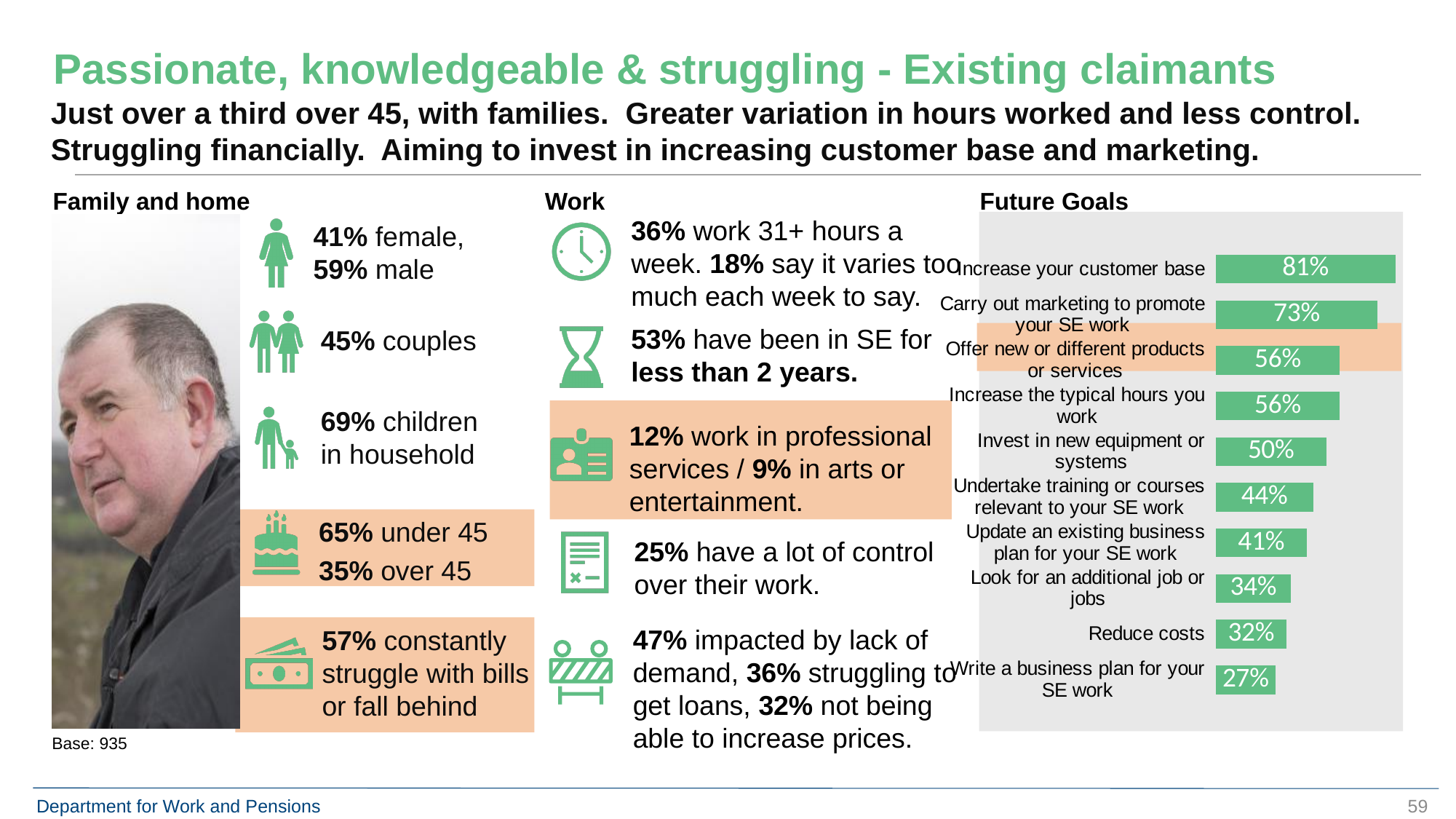
In the Future Goals chart, which goal has the lowest percentage? Write a business plan for your SE work What type of chart is the Future Goals chart? Bar chart In the Future Goals chart, what percentage is shown for "Reduce costs"? 32% In the Future Goals chart, what is the difference in percentage points between "Increase your customer base" and "Carry out marketing to promote your SE work"? 8 How many goals are listed in the Future Goals chart? 10 In the Future Goals chart, what percentage is shown for "Increase your customer base"? 81% In the Future Goals chart, what percentage is shown for "Undertake training or courses relevant to your SE work"? 44% In the Future Goals chart, what is the difference in percentage points between "Update an existing business plan for your SE work" and "Write a business plan for your SE work"? 14 In the Future Goals chart, which is larger: "Invest in new equipment or systems" or "Look for an additional job or jobs"? Invest in new equipment or systems In the Future Goals chart, which goal has the highest percentage? Increase your customer base What is the title of the bar chart on the slide? Future Goals In the Future Goals chart, which two goals share the same value of 56%? Offer new or different products or services; Increase the typical hours you work